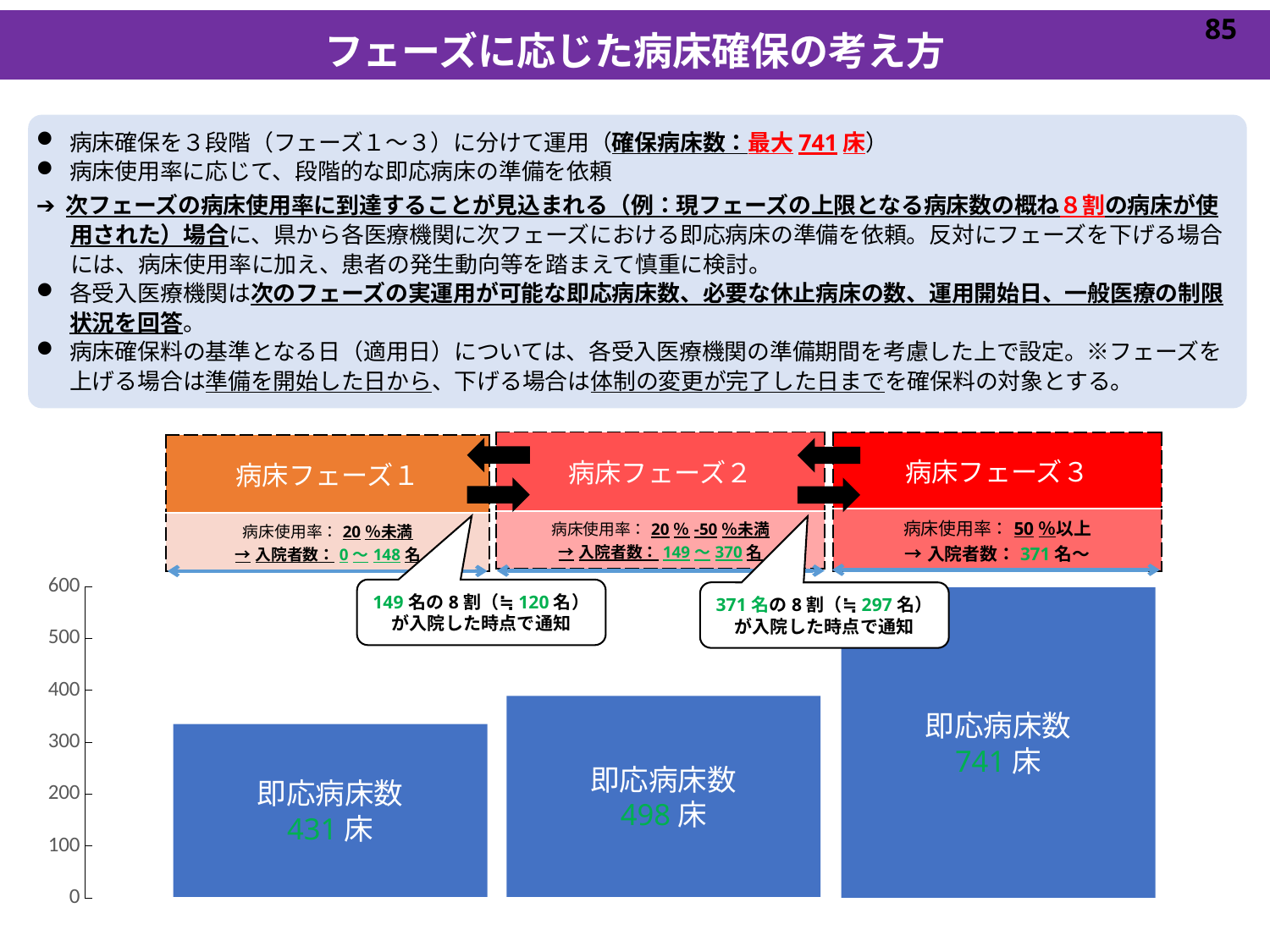
病床フェーズ1の即応病床数は何床ですか？ 431 床 病床フェーズ3と病床フェーズ1の即応病床数の差は何床ですか？ 310 床 即応病床数が最も多いのはどのフェーズですか？ 病床フェーズ3 グラフには棒がいくつありますか？ 3 フェーズ1からフェーズ3にかけて、即応病床数は増加していますか、減少していますか？ 増加 病床フェーズ3の即応病床数は何床ですか？ 741 床 病床フェーズ2と病床フェーズ1の即応病床数の差は何床ですか？ 67 床 病床フェーズ2の即応病床数は何床ですか？ 498 床 即応病床数が最も少ないのはどのフェーズですか？ 病床フェーズ1 病床フェーズ2の病床使用率の範囲はいくつですか？ 20%-50%未満 病床フェーズ1と病床フェーズ2では、どちらの即応病床数が多いですか？ 病床フェーズ2 このグラフはどの種類のグラフですか？ 棒グラフ